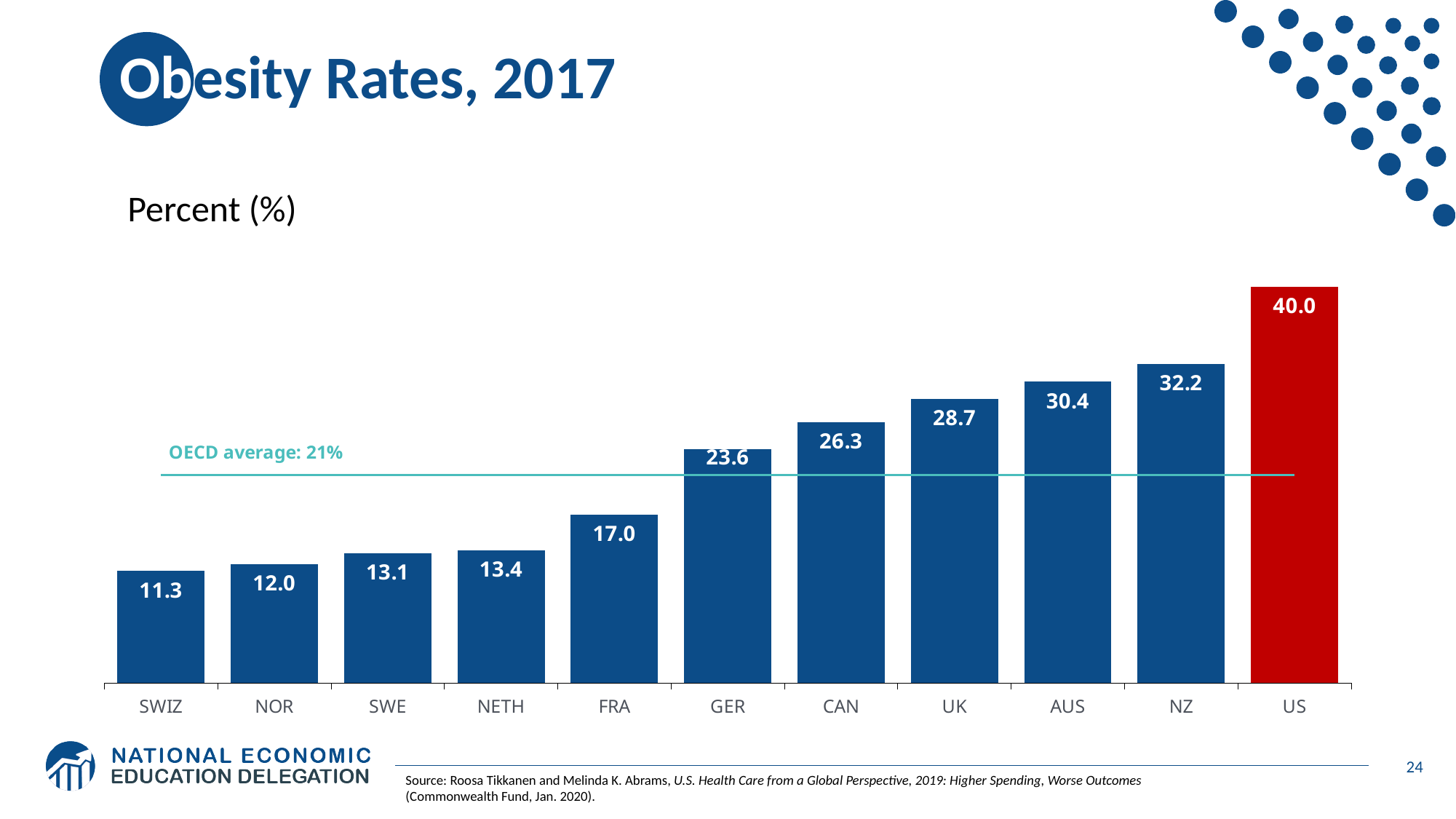
Do the obesity rates rise or fall moving from left to right across the chart? Rise What is the obesity rate shown for the US? 40.0 What OECD average is marked by the horizontal line on the chart? 21% Which country has the lowest obesity rate on the chart? SWIZ What is the obesity rate shown for GER? 23.6 What is the difference between the obesity rates of the US and NZ? 7.8 What kind of chart is shown on the slide? Bar chart How many countries are shown on the chart? 11 Which has a higher obesity rate, UK or AUS? AUS What is the difference between the obesity rates of CAN and FRA? 9.3 Which country has the highest obesity rate on the chart? US What is the obesity rate shown for NETH? 13.4